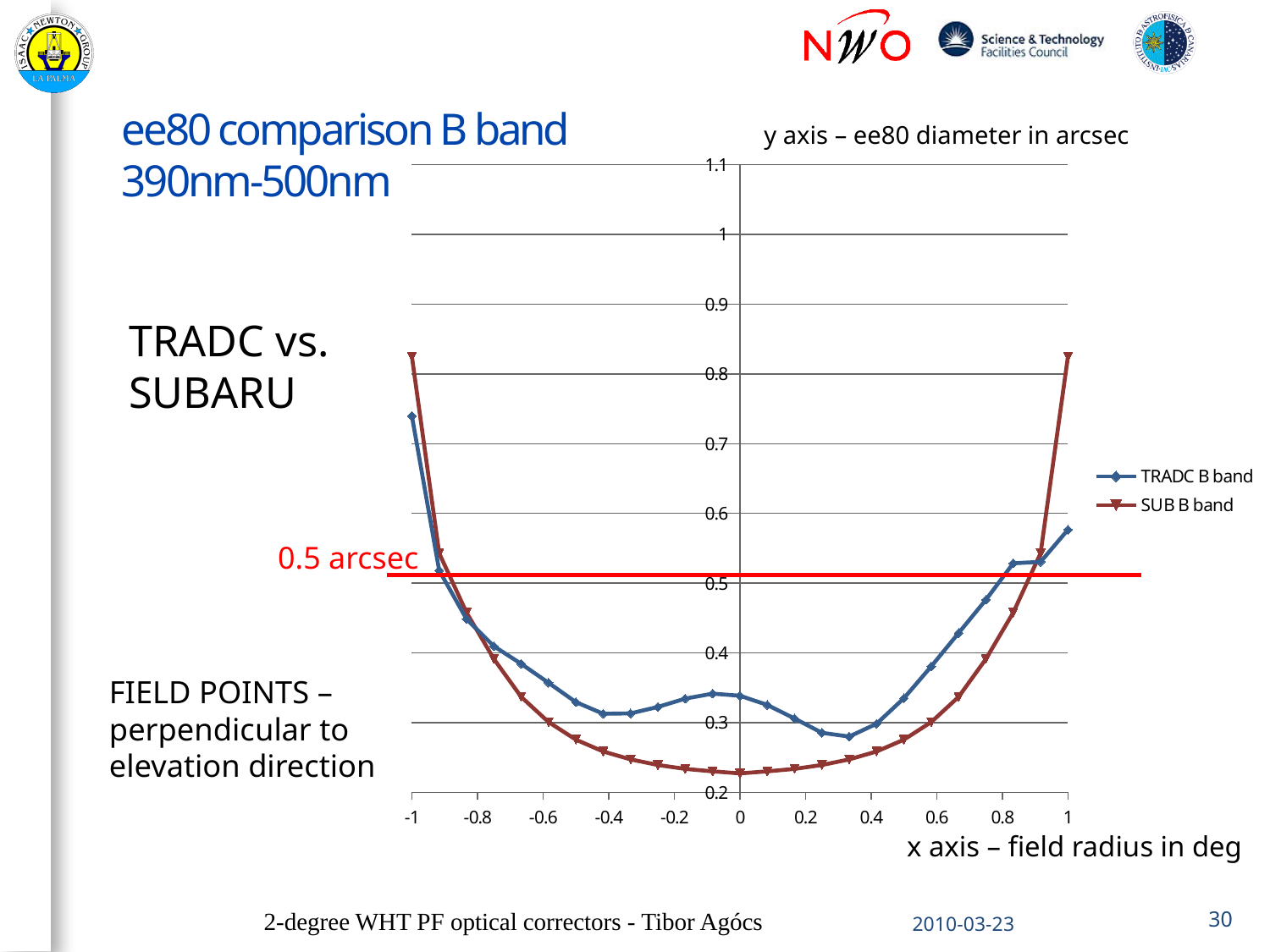
At a field radius of 1 deg, which series has the larger value, TRADC B band or SUB B band? SUB B band Is the value of SUB B band at a field radius of 0 deg greater or less than 0.3? less At a field radius of -1 deg, which series has the larger value, TRADC B band or SUB B band? SUB B band At a field radius of 0 deg, which series has the larger value, TRADC B band or SUB B band? TRADC B band What are the two series named in the legend? TRADC B band and SUB B band What quantity does the y axis represent, according to the slide? ee80 diameter in arcsec What kind of chart is shown on the slide? line chart Is the value of TRADC B band at a field radius of 0 deg greater or less than 0.4? less Does the SUB B band series rise or fall as the field radius goes from 0 to 1 deg? rise Is the value of SUB B band at a field radius of 1 deg greater or less than 0.7? greater Which series reaches the lower minimum value across the field? SUB B band How many series does the legend list? 2